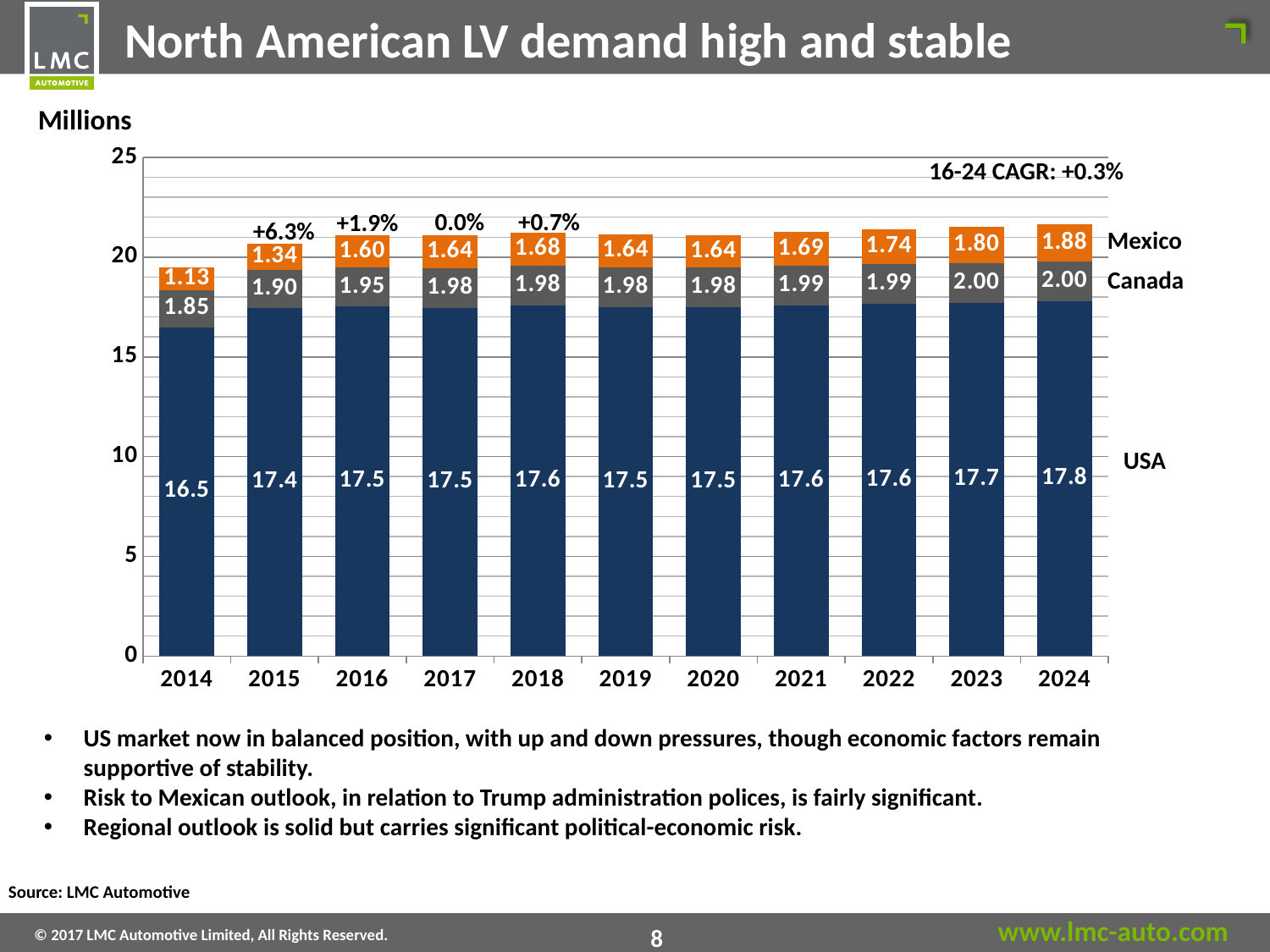
What kind of chart is shown on the slide? Stacked bar chart What is the Canada value for 2016? 1.95 What is the difference between the Mexico value in 2024 and in 2014? 0.75 What is the Mexico value for 2024? 1.88 How many series (countries) are stacked in each bar? 3 What is the USA value for 2014? 16.5 In which year is the USA value lowest? 2014 What 16-24 CAGR is annotated on the chart? +0.3% Is the total height of the 2014 bar greater or less than 20? less How many years are shown on the x axis? 11 Which is larger, the Canada value in 2024 or the Mexico value in 2024? Canada (2.00) In which year is the Mexico value highest? 2024